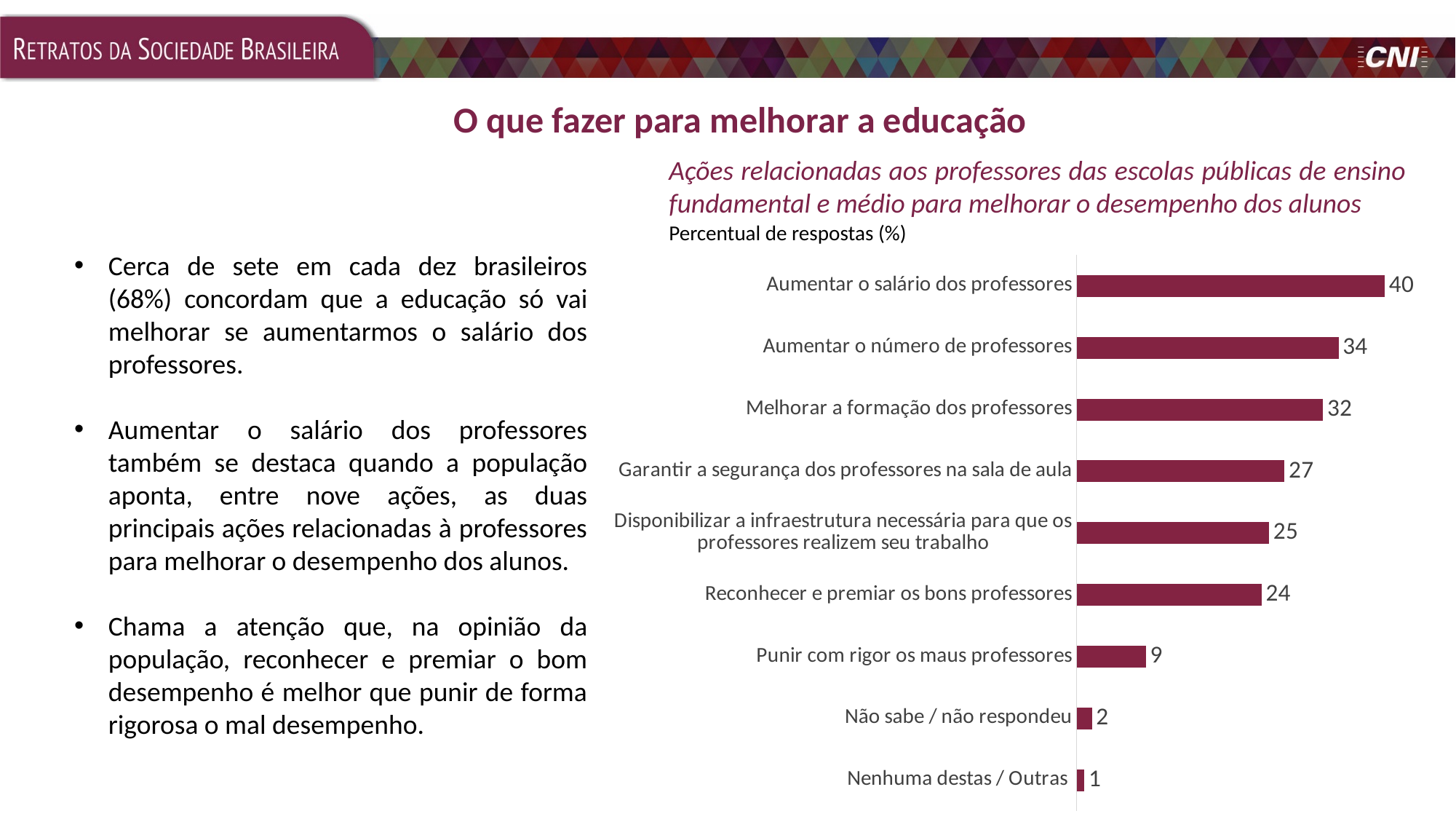
What is the value for "Punir com rigor os maus professores"? 9 What is the value for "Aumentar o salário dos professores"? 40 What is the difference between the values for "Reconhecer e premiar os bons professores" and "Punir com rigor os maus professores"? 15 How many categories are shown in the chart? 9 What unit is indicated below the chart title? Percentual de respostas (%) What kind of chart is shown on the slide? Bar chart What is the value for "Reconhecer e premiar os bons professores"? 24 What is the value for "Garantir a segurança dos professores na sala de aula"? 27 Which category has the highest value? Aumentar o salário dos professores Which category has the lowest value? Nenhuma destas / Outras What is the difference between the values for "Aumentar o salário dos professores" and "Aumentar o número de professores"? 6 Which is larger: the value for "Melhorar a formação dos professores" or the value for "Disponibilizar a infraestrutura necessária para que os professores realizem seu trabalho"? Melhorar a formação dos professores